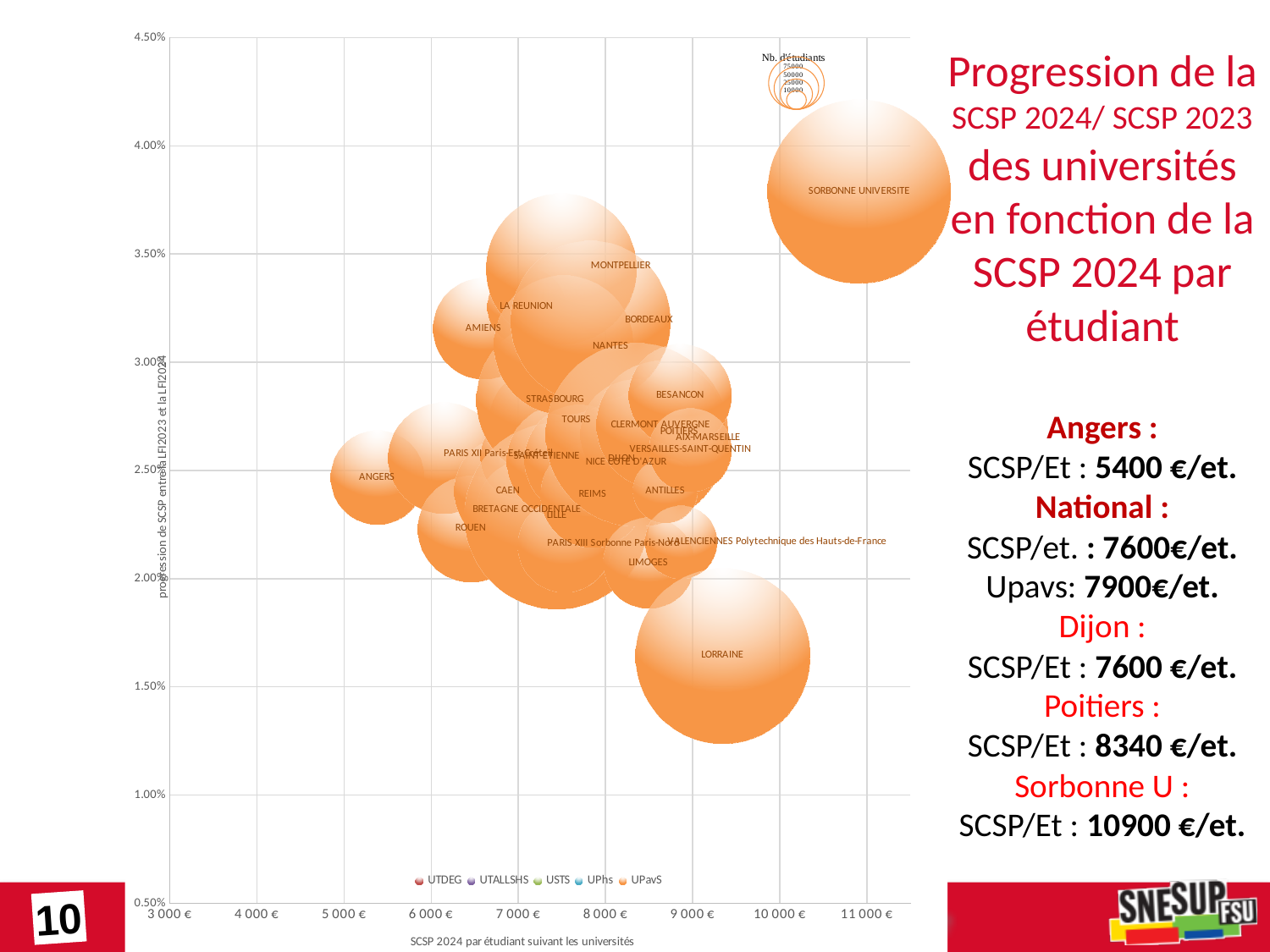
Which university has the highest progression (y-axis value) on the chart? SORBONNE UNIVERSITE Which has a higher progression value, MONTPELLIER or LORRAINE? MONTPELLIER Which university has the lowest SCSP 2024 per student (x-axis value) on the chart? ANGERS Is the progression value for LORRAINE greater or less than 2.00%? less Is the SCSP 2024 per student for SORBONNE UNIVERSITE greater or less than 10 000 €? greater Is the progression value for MONTPELLIER greater or less than 3.00%? greater How many series does the chart legend list? 5 What is the title of the x axis of the chart? SCSP 2024 par étudiant suivant les universités What kind of chart is shown on the slide? bubble chart What quantity does the bubble size represent, according to the size legend? Nb. d'étudiants Which university has the lowest progression (y-axis value) on the chart? LORRAINE